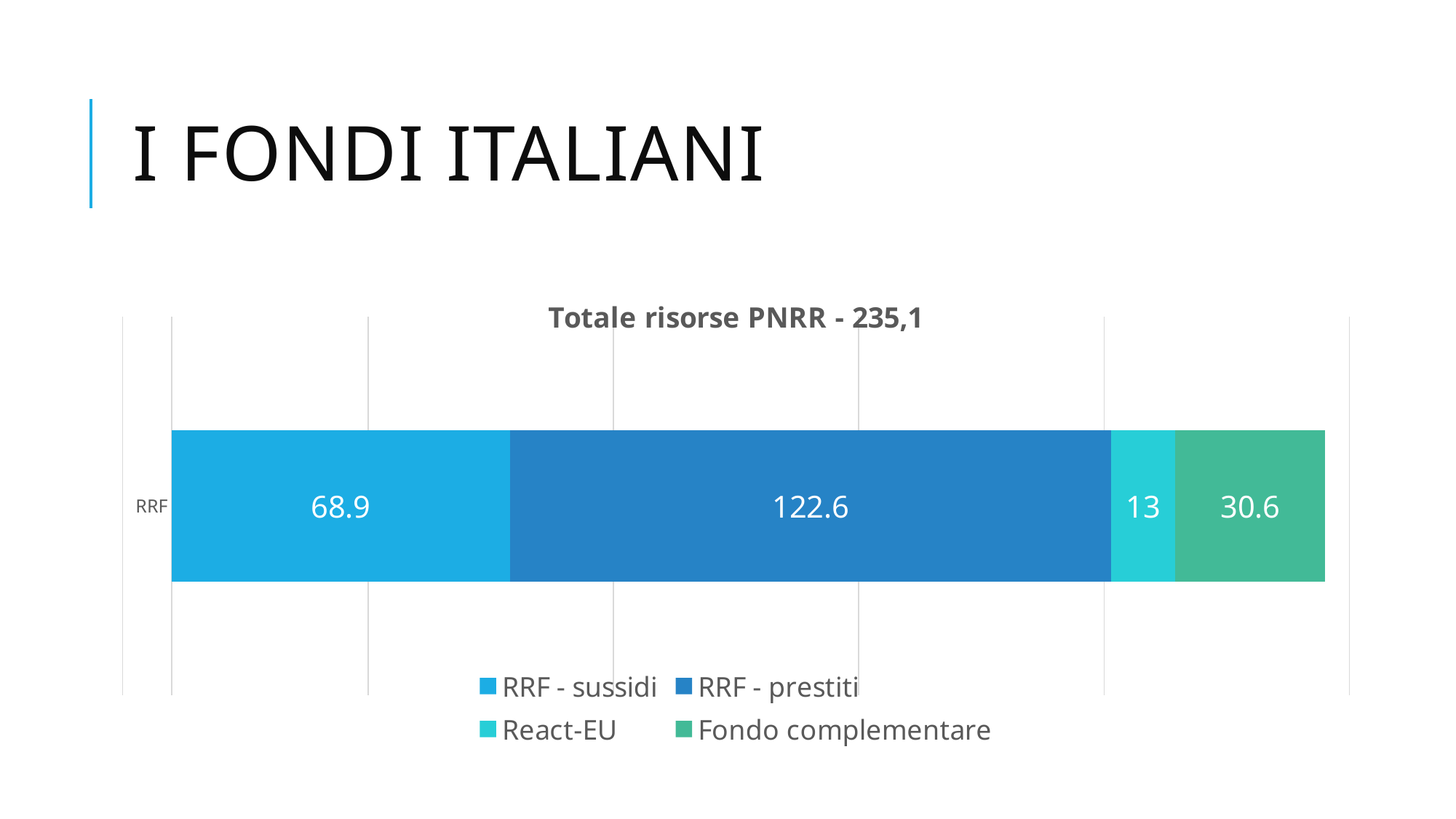
What is the value of the React-EU segment in the stacked bar? 13 What is the total of the stacked bar for RRF? 235.1 What is the difference between the RRF - prestiti and RRF - sussidi values? 53.7 What is the value of the RRF - sussidi segment in the stacked bar? 68.9 What kind of chart is shown on the slide? Stacked bar chart Which series has the largest segment in the stacked bar? RRF - prestiti What is the title of the chart? Totale risorse PNRR - 235,1 Which series has the smallest segment in the stacked bar? React-EU How many series does the legend list? 4 What is the value of the Fondo complementare segment in the stacked bar? 30.6 What is the value of the RRF - prestiti segment in the stacked bar? 122.6 Which is larger, the Fondo complementare value or the React-EU value? Fondo complementare